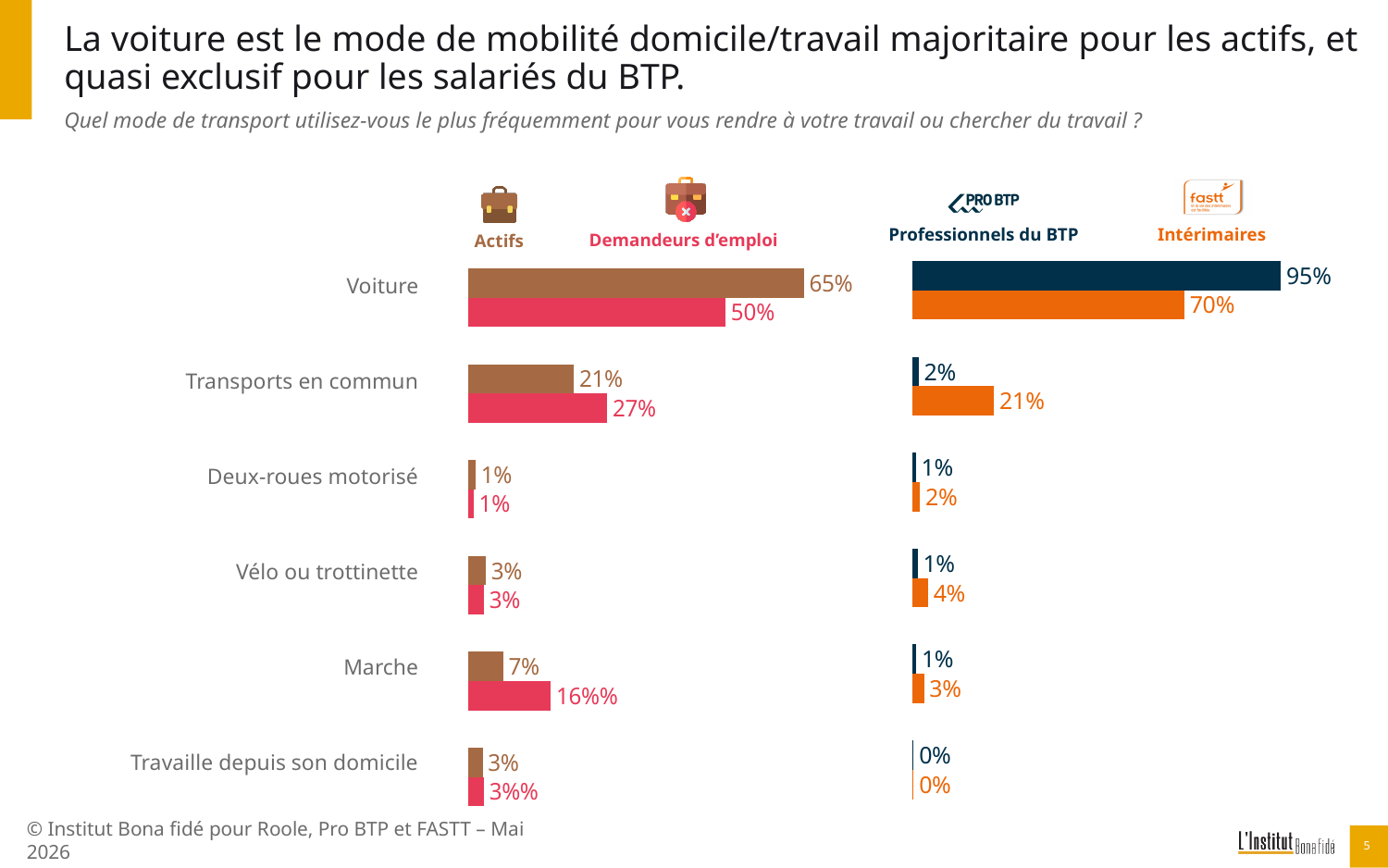
In the right chart, what is the value for Voiture for Professionnels du BTP? 95% In the right chart, what is the difference between the Professionnels du BTP and Intérimaires values for Voiture? 25% In the left chart, what is the value for Voiture for Actifs? 65% In the right chart, which category has the highest value for Intérimaires? Voiture How many series does the right chart show? 2 How many transport categories are listed on the slide? 6 In the left chart, which is larger for Transports en commun: Actifs or Demandeurs d'emploi? Demandeurs d'emploi In the left chart, what is the difference between the Actifs and Demandeurs d'emploi values for Voiture? 15% In the right chart, which category has the lowest value for Professionnels du BTP? Travaille depuis son domicile In the left chart, what is the value for Transports en commun for Demandeurs d'emploi? 27% In the right chart, what is the value for Transports en commun for Intérimaires? 21% What type of chart is used on the slide? Bar chart